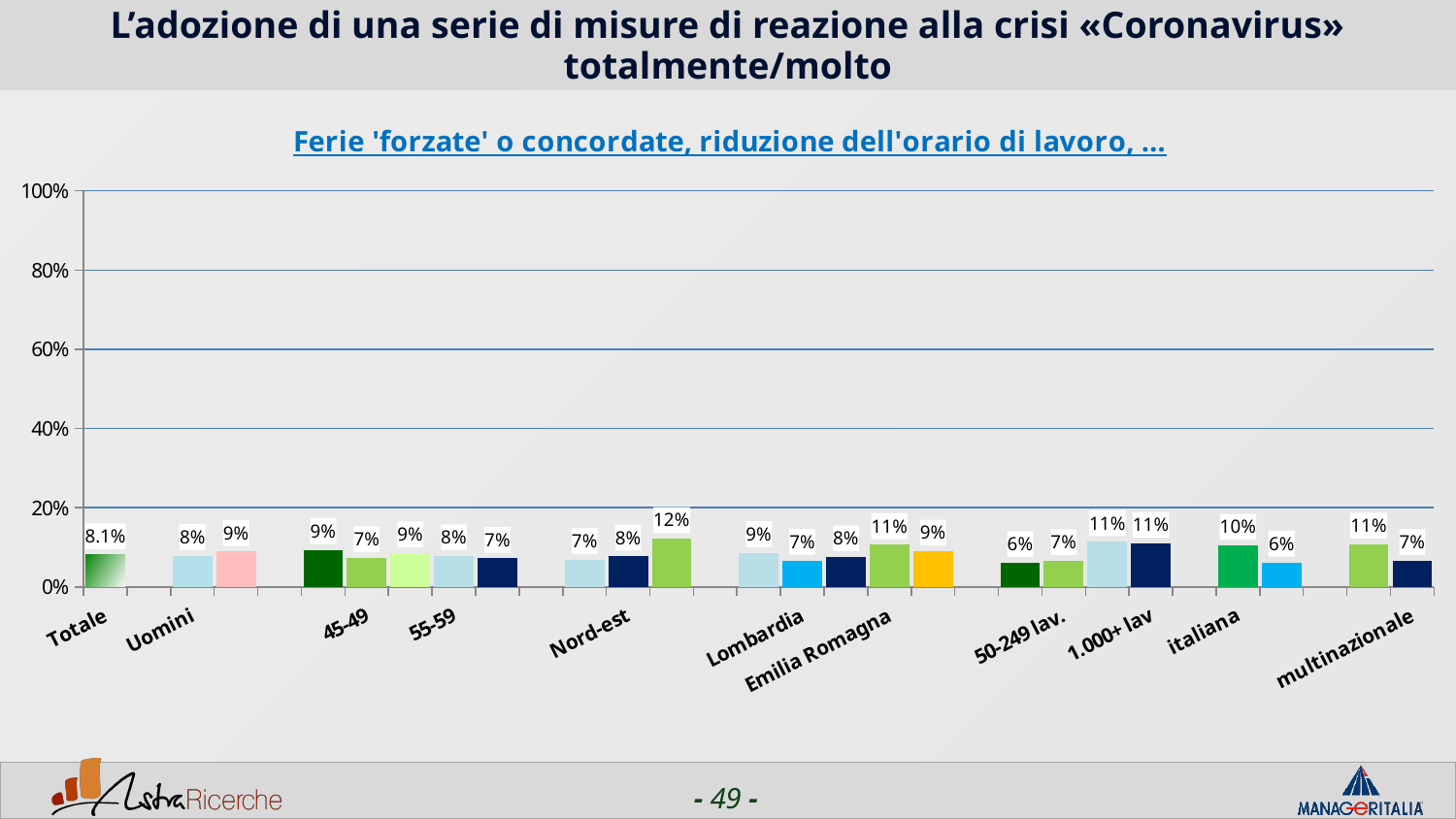
What is the value for Uomini? 8% What is the value for Totale? 8.1% Which is larger, the value for Emilia Romagna or the value for Lombardia? Emilia Romagna What is the difference between the values for italiana and multinazionale? 3% What is the subtitle shown above the chart? Ferie 'forzate' o concordate, riduzione dell'orario di lavoro, … What kind of chart is shown on the slide? bar chart What is the value for 1.000+ lav? 11% What is the value for italiana? 10% What is the value for Emilia Romagna? 11% What is the highest value labelled on any bar in the chart? 12% What is the value for multinazionale? 7% Is the value for Nord-est greater or less than 20%? less